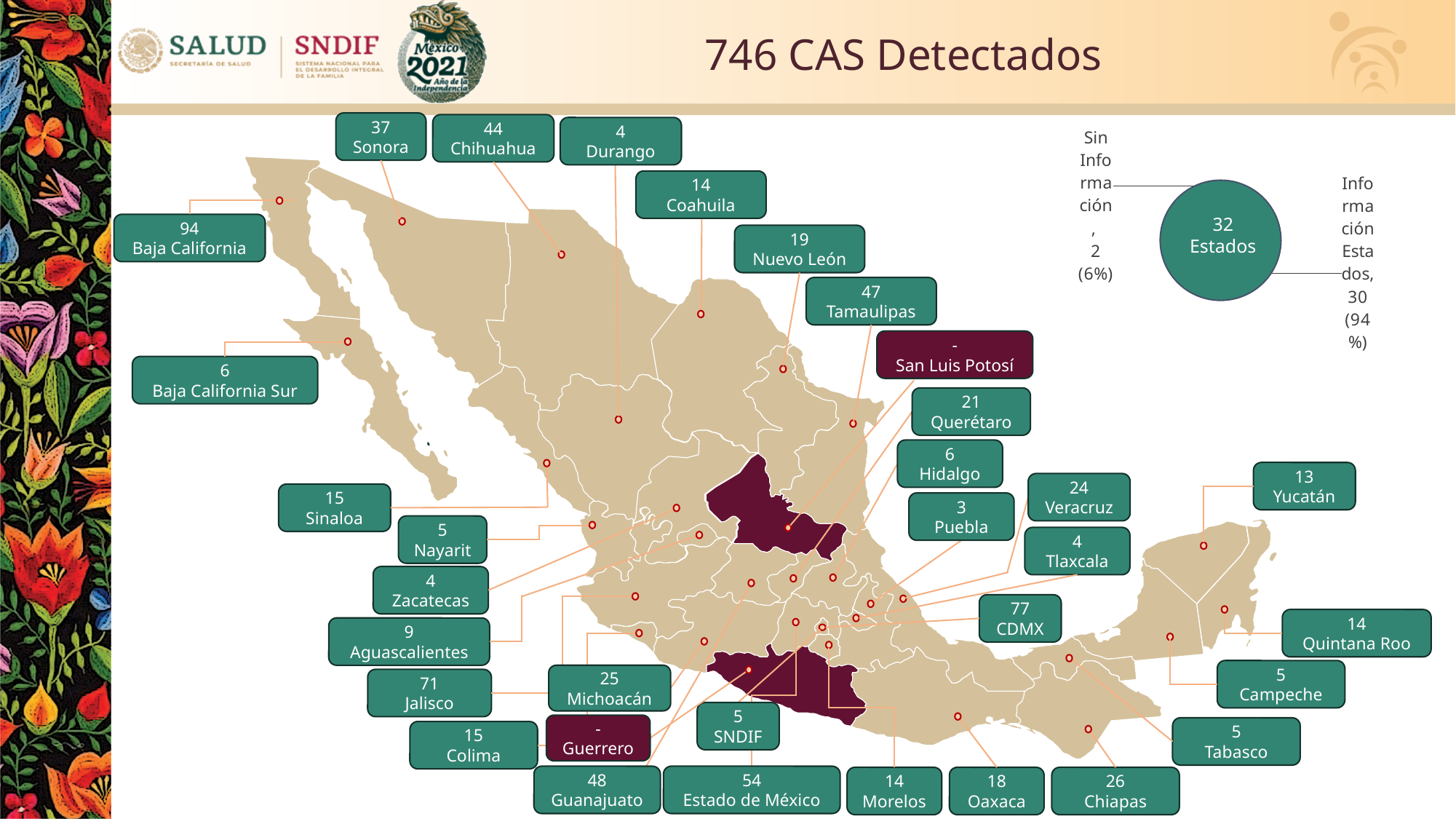
In the pie chart, which slice is the largest? Información Estados In the pie chart, how many states are labelled 'Sin Información'? 2 How many slices does the pie chart have? 2 In the pie chart, which slice is the smallest? Sin Información In the pie chart, what percentage share does 'Sin Información' have? 6% What is the total number of states represented in the pie chart? 32 In the pie chart, what is the difference between the number of states with 'Información Estados' and those with 'Sin Información'? 28 What kind of chart is shown on the right side of the slide next to the map? doughnut chart What text is written in the centre of the pie chart? 32 Estados In the pie chart, how many states are labelled 'Información Estados'? 30 On the map, what value is shown for CDMX? 77 In the pie chart, what percentage share does 'Información Estados' have? 94%